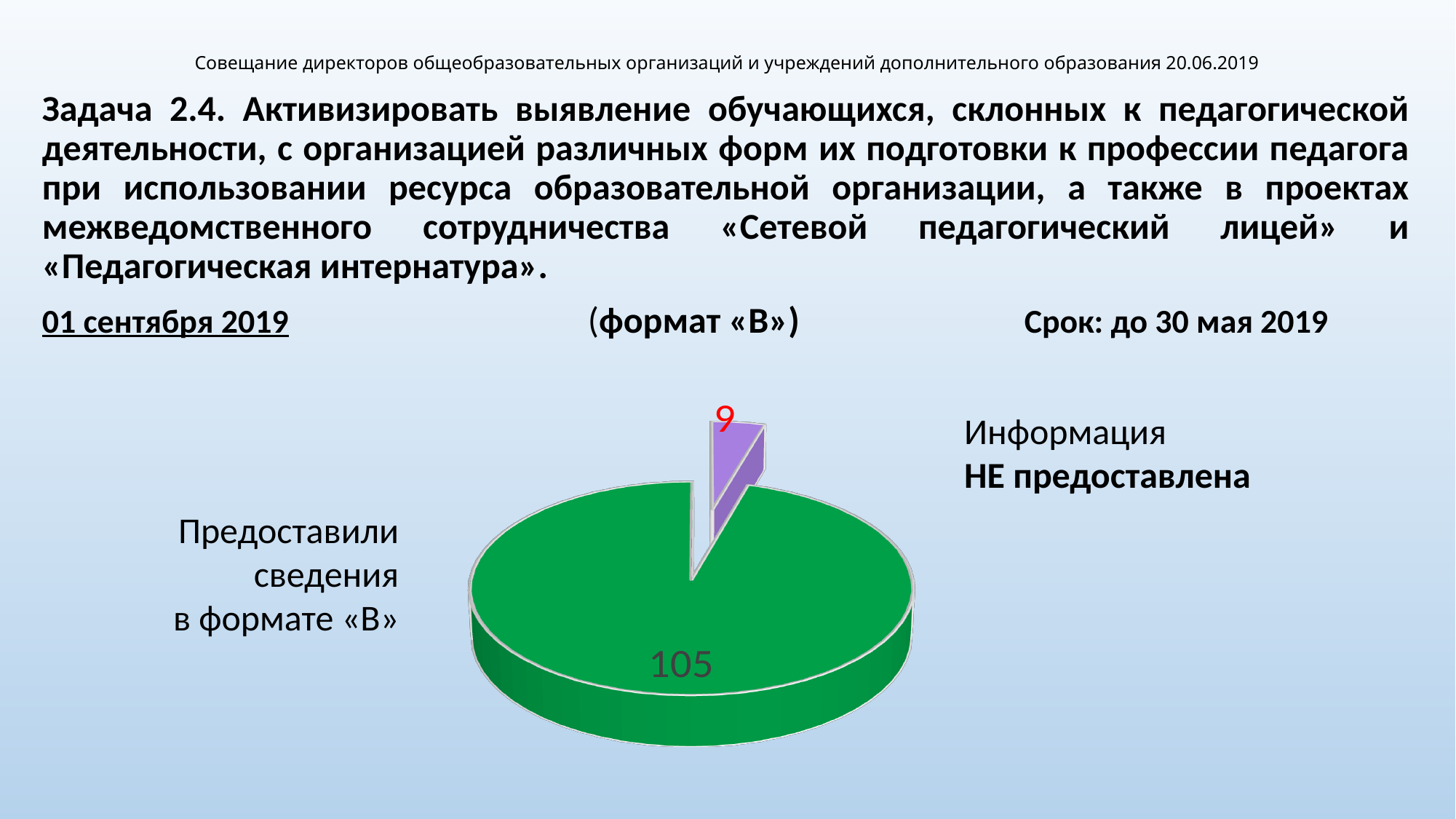
What kind of chart is shown on the slide? Pie chart What colour is the slice representing organisations that provided information in format «В»? Green How many organisations provided information in format «В» according to the pie chart? 105 Which is larger: the number that provided information in format «В» or the number that did not provide information? Предоставили сведения в формате «В» Which slice of the pie chart is the largest? Предоставили сведения в формате «В» What is the difference between the number that provided information in format «В» and the number that did not provide information? 96 Which slice of the pie chart is the smallest? Информация НЕ предоставлена What share of the pie does the slice with value 105 represent? 92.1% What colour is the slice representing «Информация НЕ предоставлена»? Purple How many slices does the pie chart have? 2 What value is shown for the slice labelled «Информация НЕ предоставлена»? 9 What is the total of the two values shown in the pie chart? 114